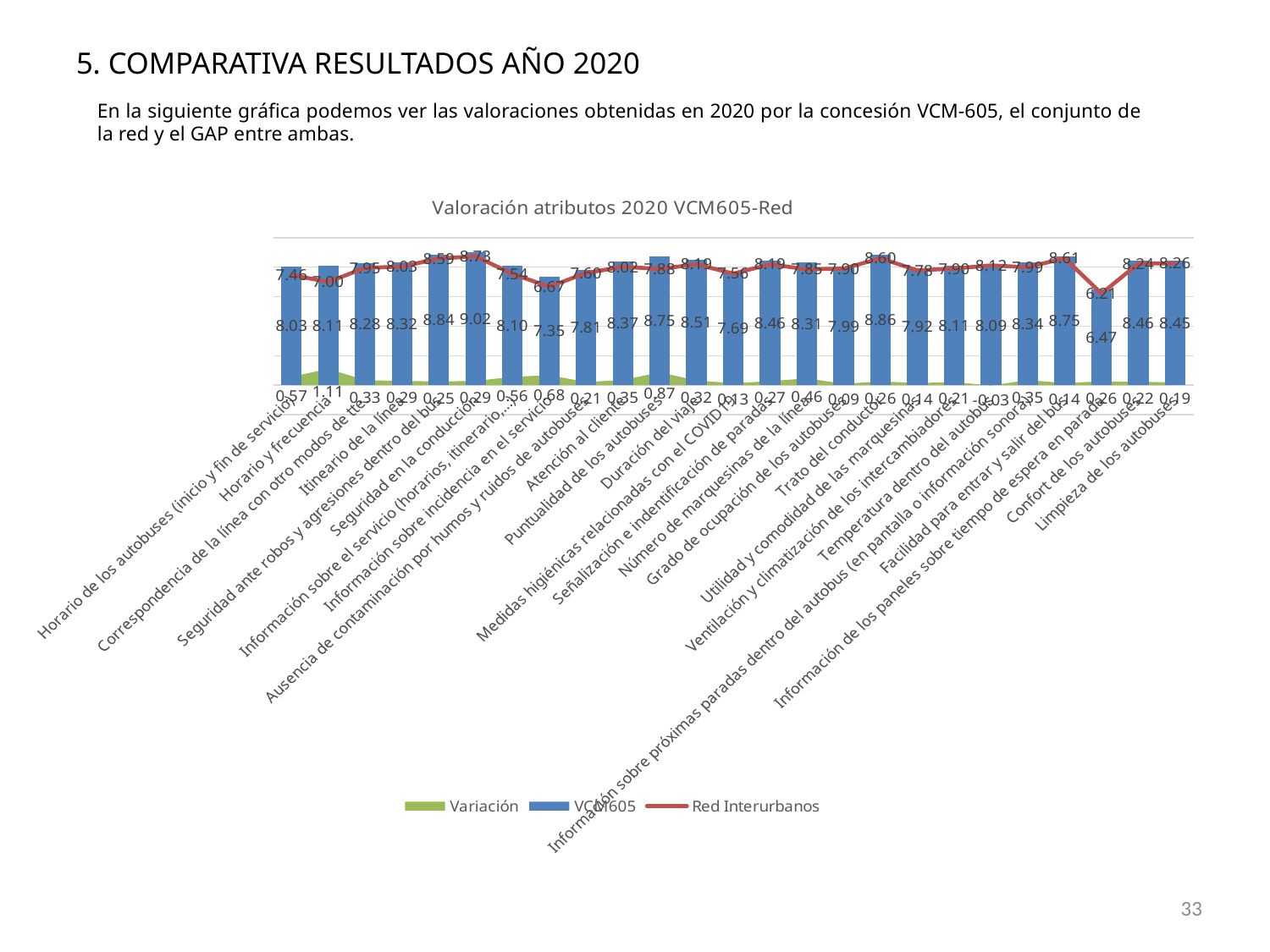
What is the Variación value for Horario y frecuencia? 1.11 What is the title of the chart? Valoración atributos 2020 VCM605-Red Which category has the highest VCM605 value? Seguridad en la conducción What is the difference between the VCM605 value and the Red Interurbanos value for Puntualidad de los autobuses? 0.87 What is the VCM605 value for Seguridad en la conducción? 9.02 Which series is drawn as a red line? Red Interurbanos Which is larger for Temperatura dentro del autobús: the VCM605 value or the Red Interurbanos value? Red Interurbanos What is the Red Interurbanos value for Trato del conductor? 8.60 How many series does the legend list? 3 Which category has the highest Variación value? Horario y frecuencia Which category has the lowest Red Interurbanos value? Información de los paneles sobre tiempo de espera en parada How many categories are shown on the x axis? 25